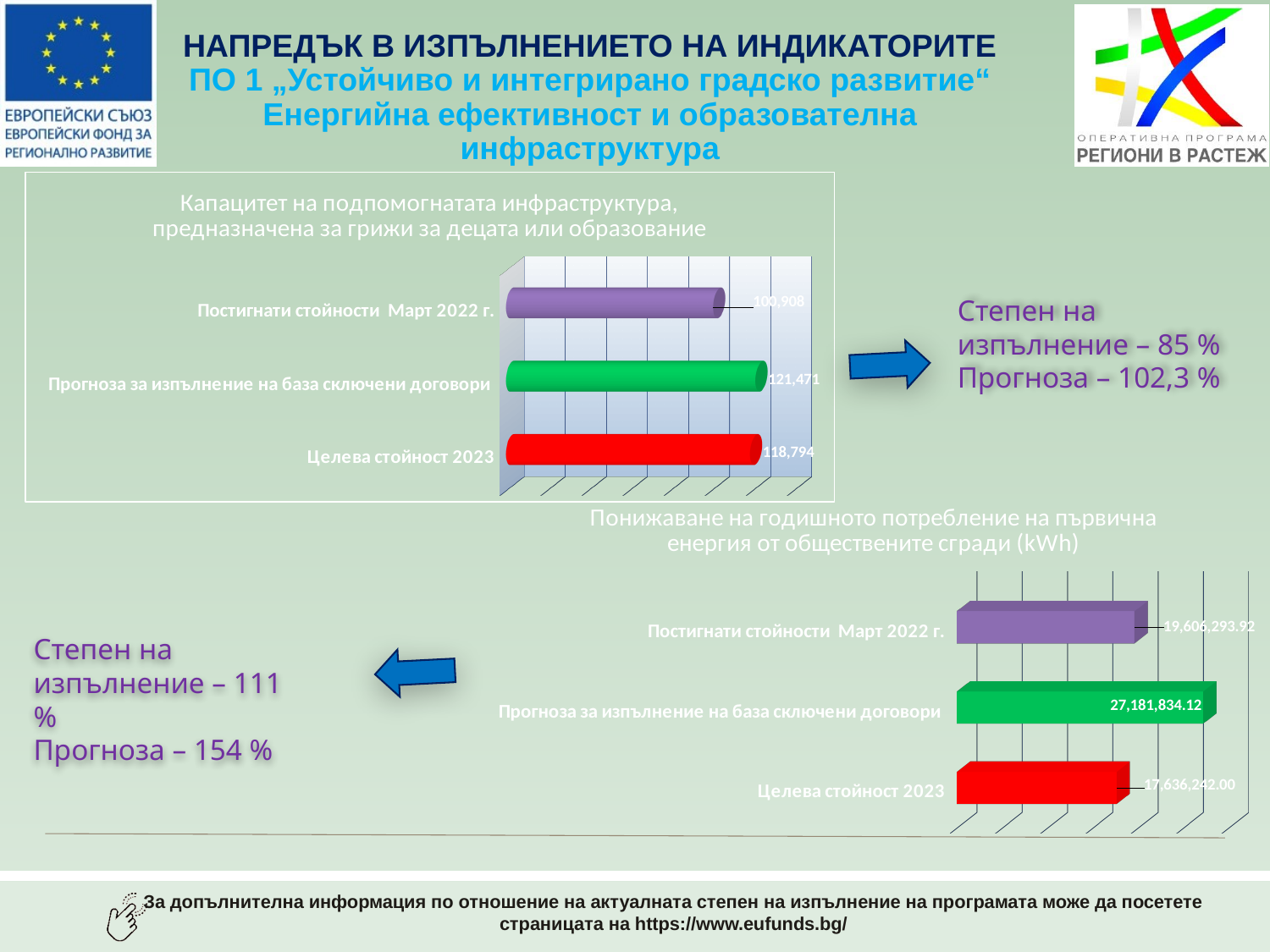
In the bottom chart (Понижаване на годишното потребление на първична енергия), what is the value for Прогноза за изпълнение на база сключени договори? 27,181,834.12 What kind of chart is the top chart (Капацитет на подпомогнатата инфраструктура)? Bar chart In the bottom chart (Понижаване на годишното потребление на първична енергия), which is larger: Постигнати стойности Март 2022 г. or Целева стойност 2023? Постигнати стойности Март 2022 г. In the top chart (Капацитет на подпомогнатата инфраструктура), what is the value for Целева стойност 2023? 118,794 In the top chart (Капацитет на подпомогнатата инфраструктура), what is the value for Постигнати стойности Март 2022 г.? 100,908 In the top chart (Капацитет на подпомогнатата инфраструктура), what is the value for Прогноза за изпълнение на база сключени договори? 121,471 In the bottom chart (Понижаване на годишното потребление на първична енергия), what is the value for Целева стойност 2023? 17,636,242.00 In the bottom chart (Понижаване на годишното потребление на първична енергия), what is the value for Постигнати стойности Март 2022 г.? 19,606,293.92 In the top chart (Капацитет на подпомогнатата инфраструктура), which category has the lowest value? Постигнати стойности Март 2022 г. In the top chart (Капацитет на подпомогнатата инфраструктура), which category has the highest value? Прогноза за изпълнение на база сключени договори In the top chart (Капацитет на подпомогнатата инфраструктура), what is the difference between Прогноза за изпълнение на база сключени договори and Целева стойност 2023? 2,677 How many categories does the bottom chart (Понижаване на годишното потребление на първична енергия) show? 3